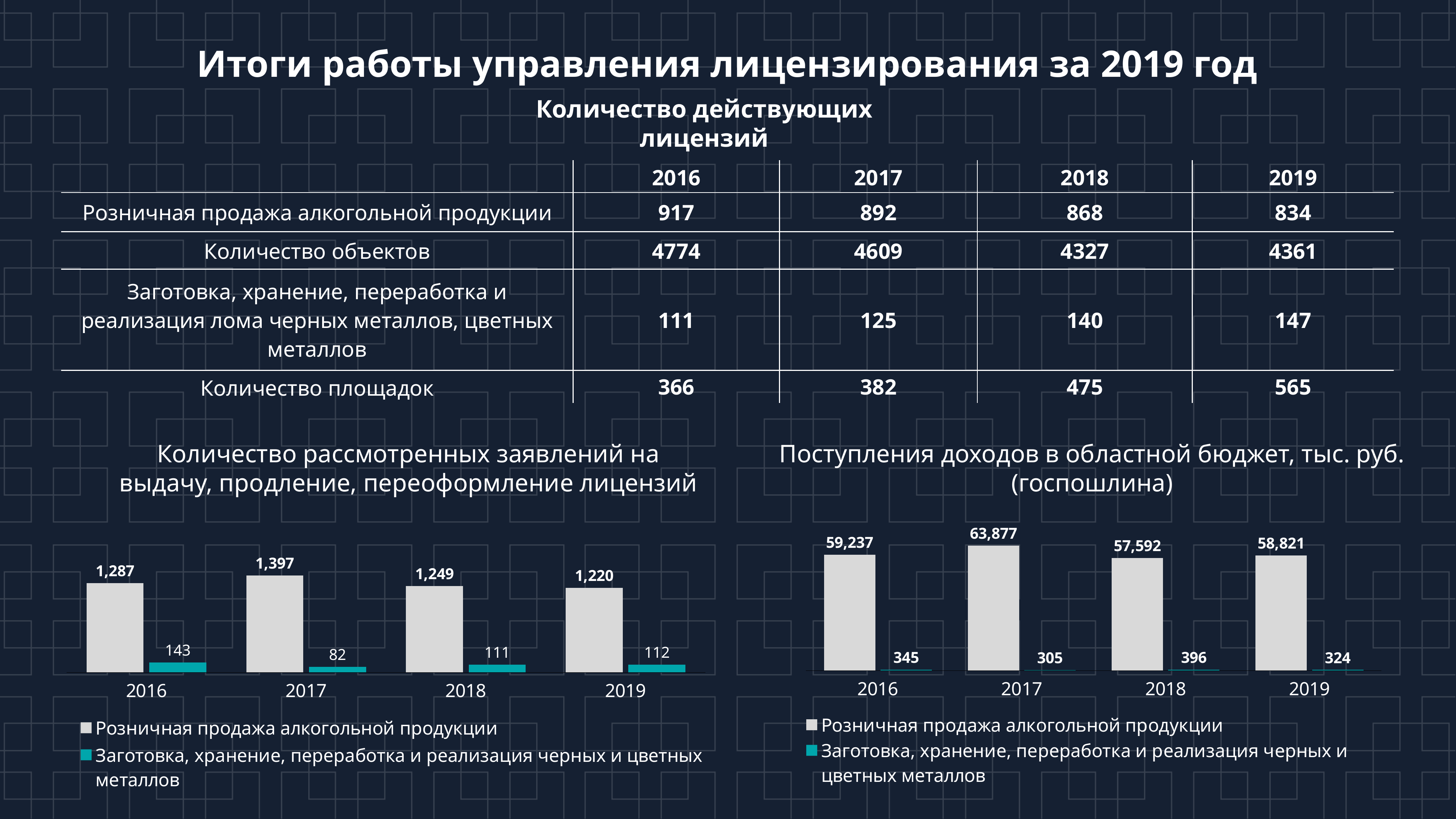
In the right chart (Поступления доходов в областной бюджет), what is the value for Розничная продажа алкогольной продукции in 2018? 57,592 In the left chart (Количество рассмотренных заявлений), how many years are shown on the x axis? 4 In the left chart (Количество рассмотренных заявлений), which year has the lowest value for Заготовка, хранение, переработка и реализация черных и цветных металлов? 2017 In the left chart (Количество рассмотренных заявлений), what is the value for Розничная продажа алкогольной продукции in 2017? 1,397 In the left chart (Количество рассмотренных заявлений), what is the value for Заготовка, хранение, переработка и реализация черных и цветных металлов in 2016? 143 In the right chart (Поступления доходов в областной бюджет), which year has the highest value for Розничная продажа алкогольной продукции? 2017 What type of chart is the right chart (Поступления доходов в областной бюджет)? bar chart In the right chart (Поступления доходов в областной бюджет), what is the value for Заготовка, хранение, переработка и реализация черных и цветных металлов in 2018? 396 In the left chart (Количество рассмотренных заявлений), what is the difference between the Розничная продажа алкогольной продукции values for 2016 and 2019? 67 In the left chart (Количество рассмотренных заявлений), which year has the highest value for Розничная продажа алкогольной продукции? 2017 In the right chart (Поступления доходов в областной бюджет), is the Заготовка value for 2017 larger or smaller than the value for 2019? smaller In the right chart (Поступления доходов в областной бюджет), how many series does the legend list? 2